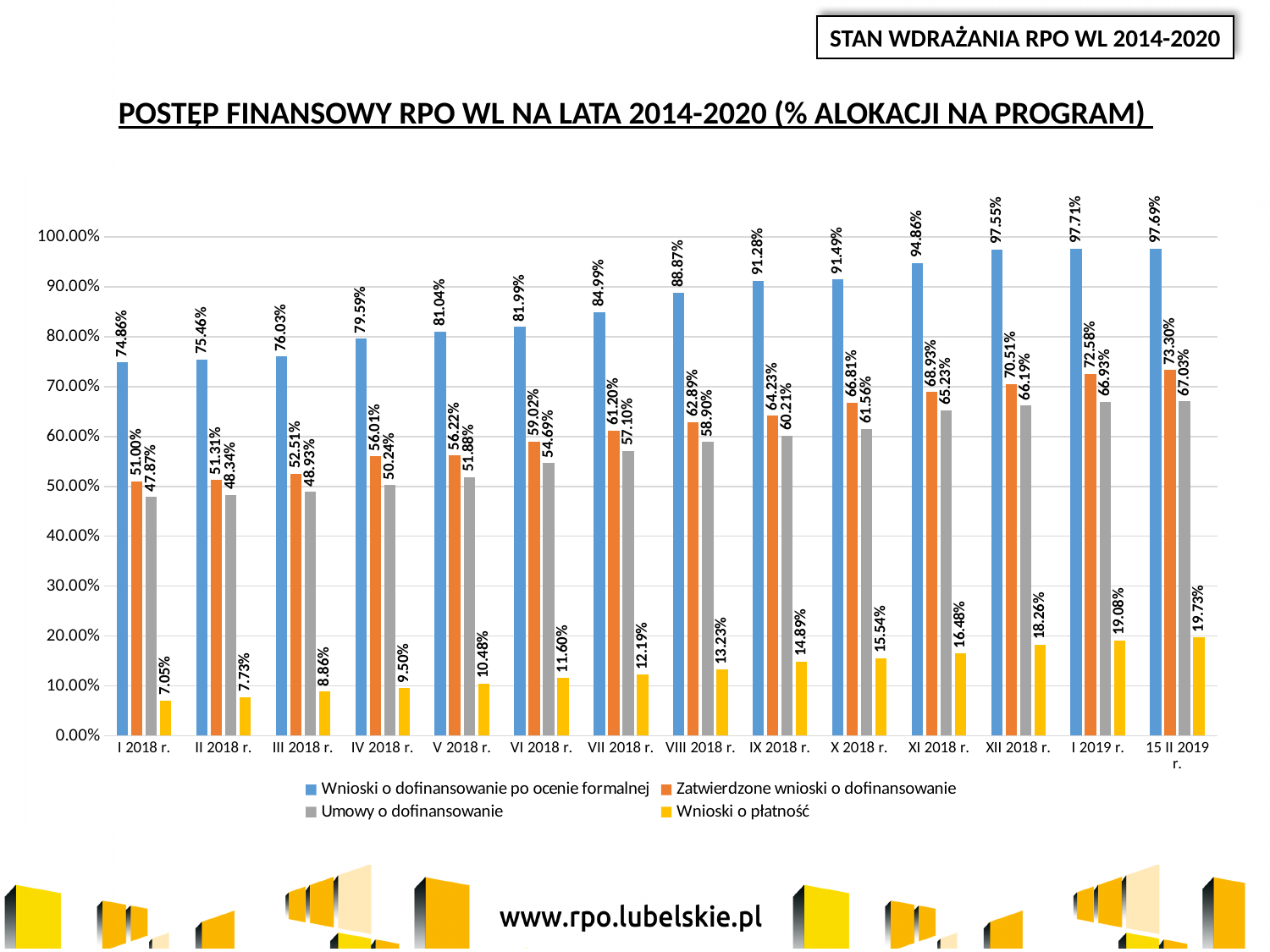
What is the value of 'Wnioski o płatność' for 15 II 2019 r.? 19.73% In which period is 'Wnioski o płatność' the highest? 15 II 2019 r. What is the value of 'Umowy o dofinansowanie' for VI 2018 r.? 54.69% How many series does the legend list? 4 What type of chart is shown on the slide? bar chart Do the values of 'Wnioski o płatność' rise or fall from I 2018 r. to 15 II 2019 r.? rise How many time periods (categories) are shown on the x axis? 14 What is the value of 'Wnioski o dofinansowanie po ocenie formalnej' for I 2018 r.? 74.86% Which is larger for XII 2018 r.: 'Zatwierdzone wnioski o dofinansowanie' or 'Umowy o dofinansowanie'? Zatwierdzone wnioski o dofinansowanie In which period is 'Wnioski o płatność' the lowest? I 2018 r. What is the difference between 'Wnioski o dofinansowanie po ocenie formalnej' and 'Zatwierdzone wnioski o dofinansowanie' for 15 II 2019 r.? 24.39% What is the value of 'Zatwierdzone wnioski o dofinansowanie' for X 2018 r.? 66.81%